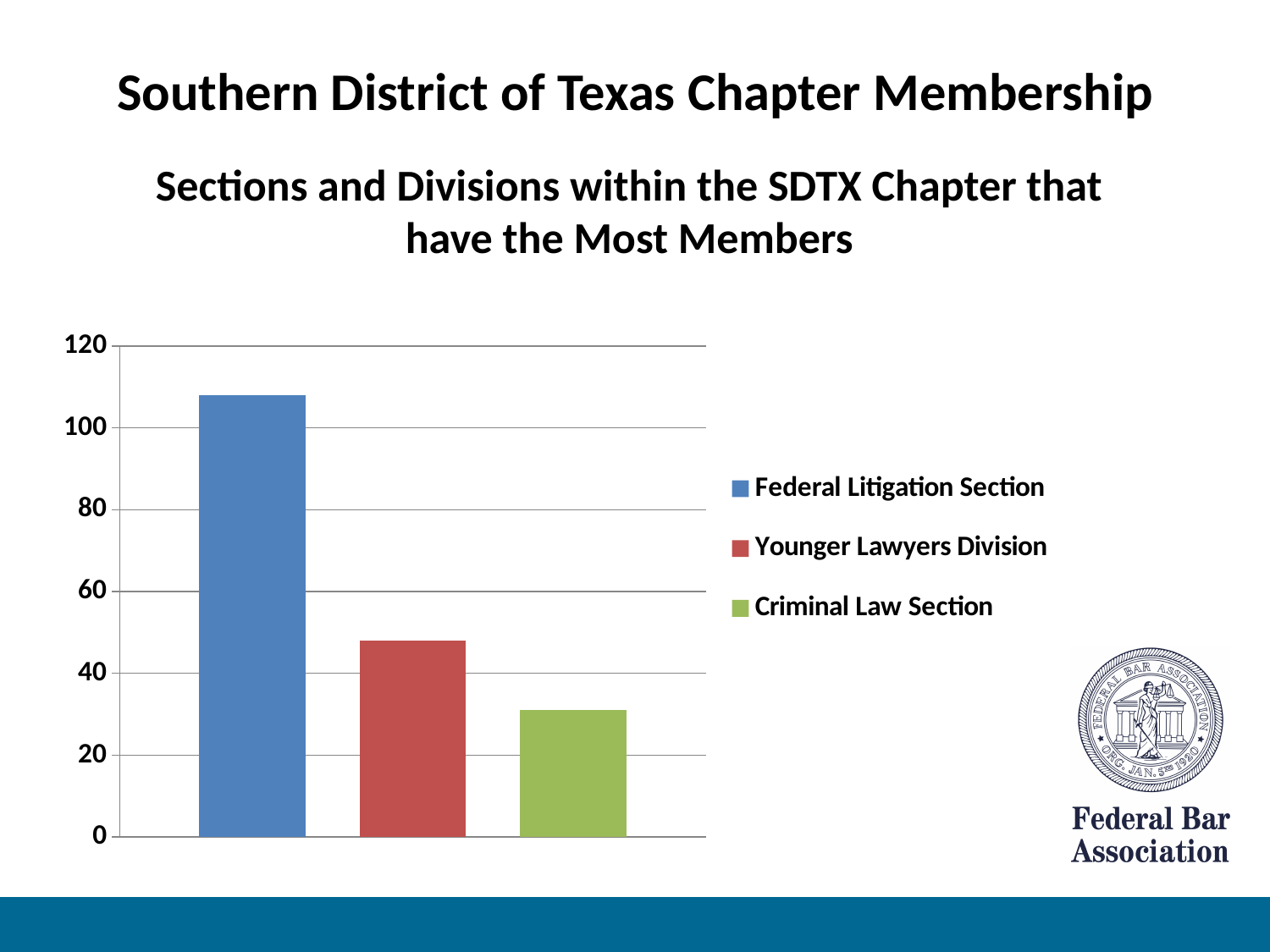
Is the value for Federal Litigation Section greater or less than 100? greater How many entries does the legend list? 3 What colour is the bar for Younger Lawyers Division? red Is the value for Younger Lawyers Division greater or less than 40? greater Which has more members, Younger Lawyers Division or Criminal Law Section? Younger Lawyers Division Is the value for Criminal Law Section greater or less than 20? greater What kind of chart is shown on the slide? bar chart Which section or division has the lowest number of members? Criminal Law Section Which section or division has the highest number of members? Federal Litigation Section How many bars are plotted in the chart? 3